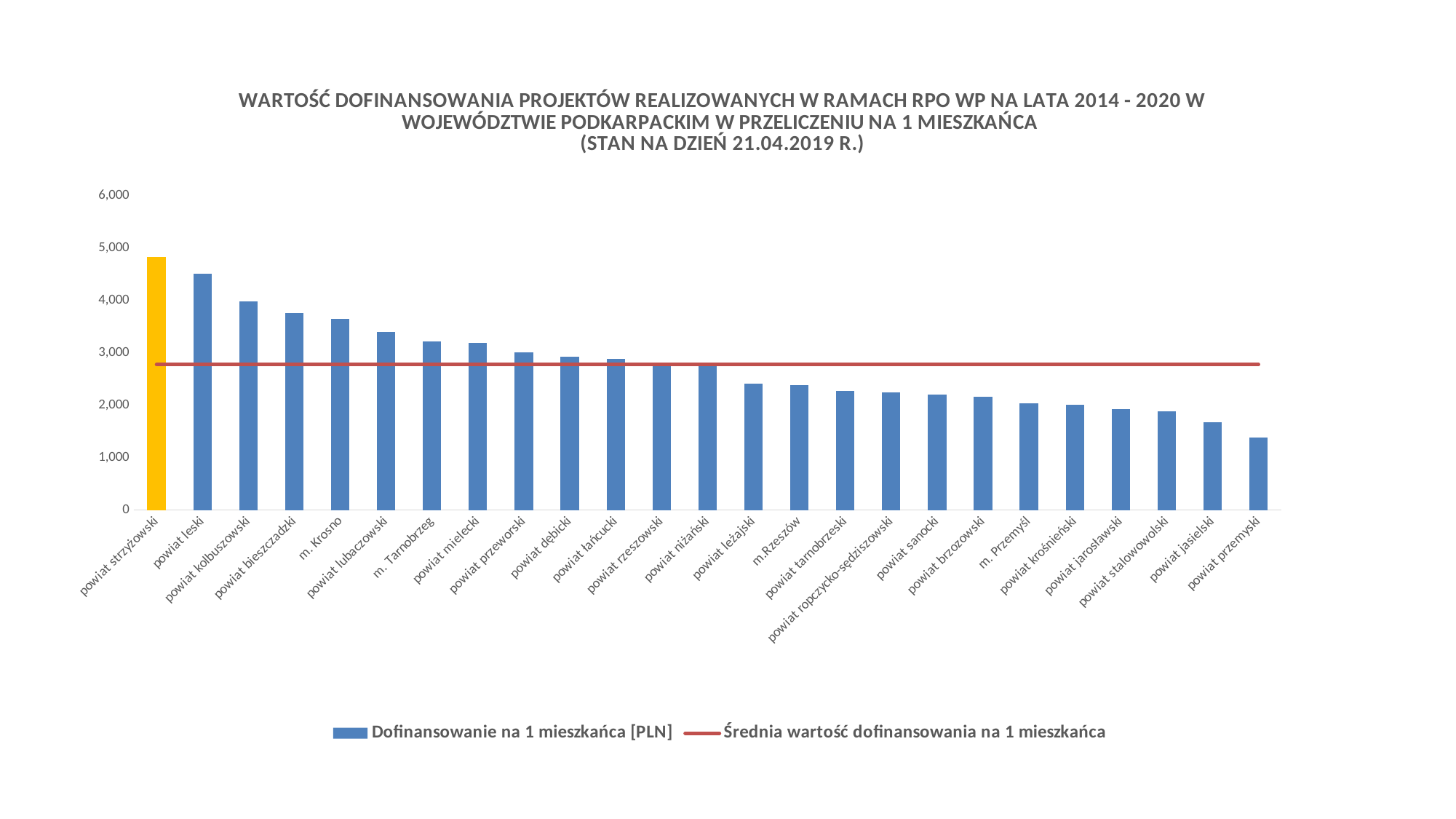
Is the value for powiat strzyżowski greater or less than 4,000? greater Is the value for powiat jasielski greater or less than 2,000? less Which category has the highest value for Dofinansowanie na 1 mieszkańca? powiat strzyżowski Which category has the lowest value for Dofinansowanie na 1 mieszkańca? powiat przemyski Is the value for powiat przemyski greater or less than 2,000? less Do the bar values rise or fall from left to right along the x axis? fall How many series does the legend list? 2 What kind of chart is shown on the slide? bar chart What colour is the bar for powiat strzyżowski? yellow Which is larger, the value for powiat leski or the value for m. Krosno? powiat leski How many categories are plotted on the x axis? 25